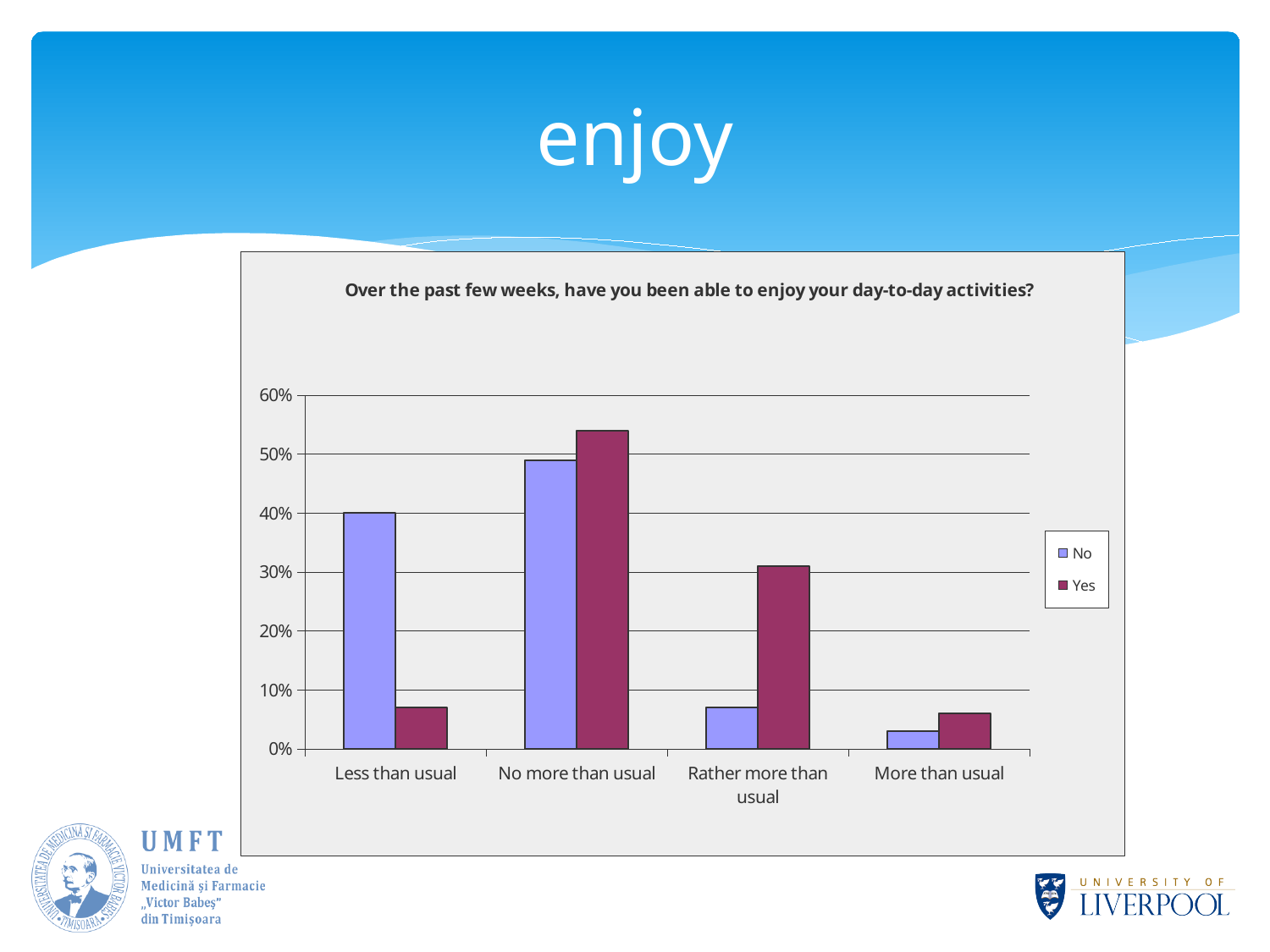
Is the No value for 'Less than usual' greater or less than 30%? greater Which category has the highest value for the No series? No more than usual For 'Less than usual', which series has the larger value, No or Yes? No Which category has the highest value for the Yes series? No more than usual Which category has the lowest value for the No series? More than usual What kind of chart is shown on the slide? bar chart For 'Rather more than usual', which series has the larger value, No or Yes? Yes What are the two entries listed in the legend? No and Yes Is the No value for 'More than usual' greater or less than 10%? less How many response categories are shown on the x axis? 4 Is the Yes value for 'No more than usual' greater or less than 50%? greater How many series does the legend list? 2